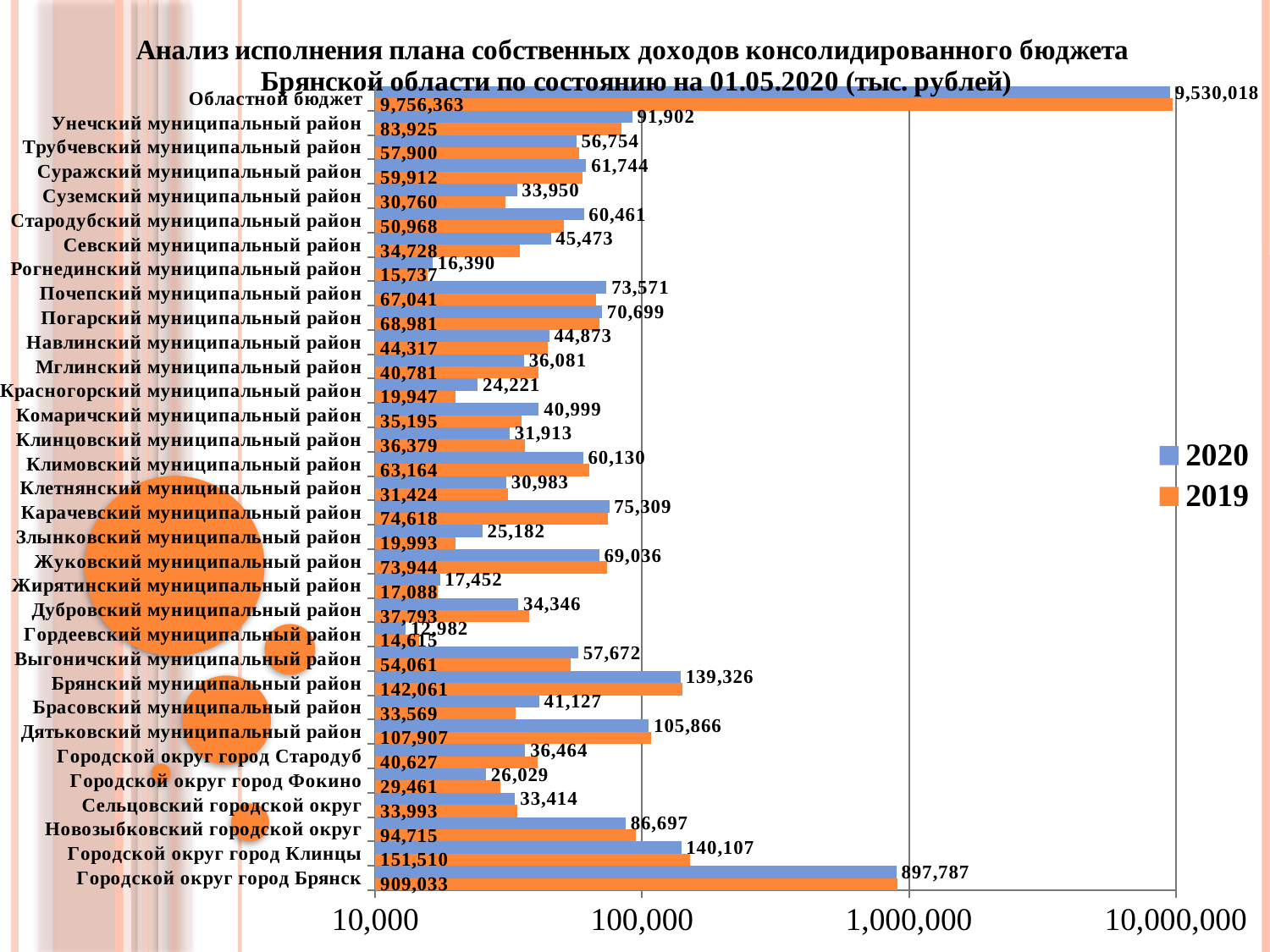
How many series does the legend list? 2 Which category has the highest 2019 value? Областной бюджет How many categories are shown on the chart? 33 Which is larger for Севский муниципальный район, the 2020 value or the 2019 value? 2020 What is the 2020 value for Унечский муниципальный район? 91,902 What is the 2019 value for Областной бюджет? 9,756,363 What is the 2019 value for Брянский муниципальный район? 142,061 What is the 2020 value for Городской округ город Брянск? 897,787 What is the difference between the 2020 and 2019 values for Городской округ город Клинцы? 11,403 What kind of chart is shown on the slide? bar chart Which colour represents the 2019 series in the legend? orange Which category has the lowest 2020 value? Гордеевский муниципальный район